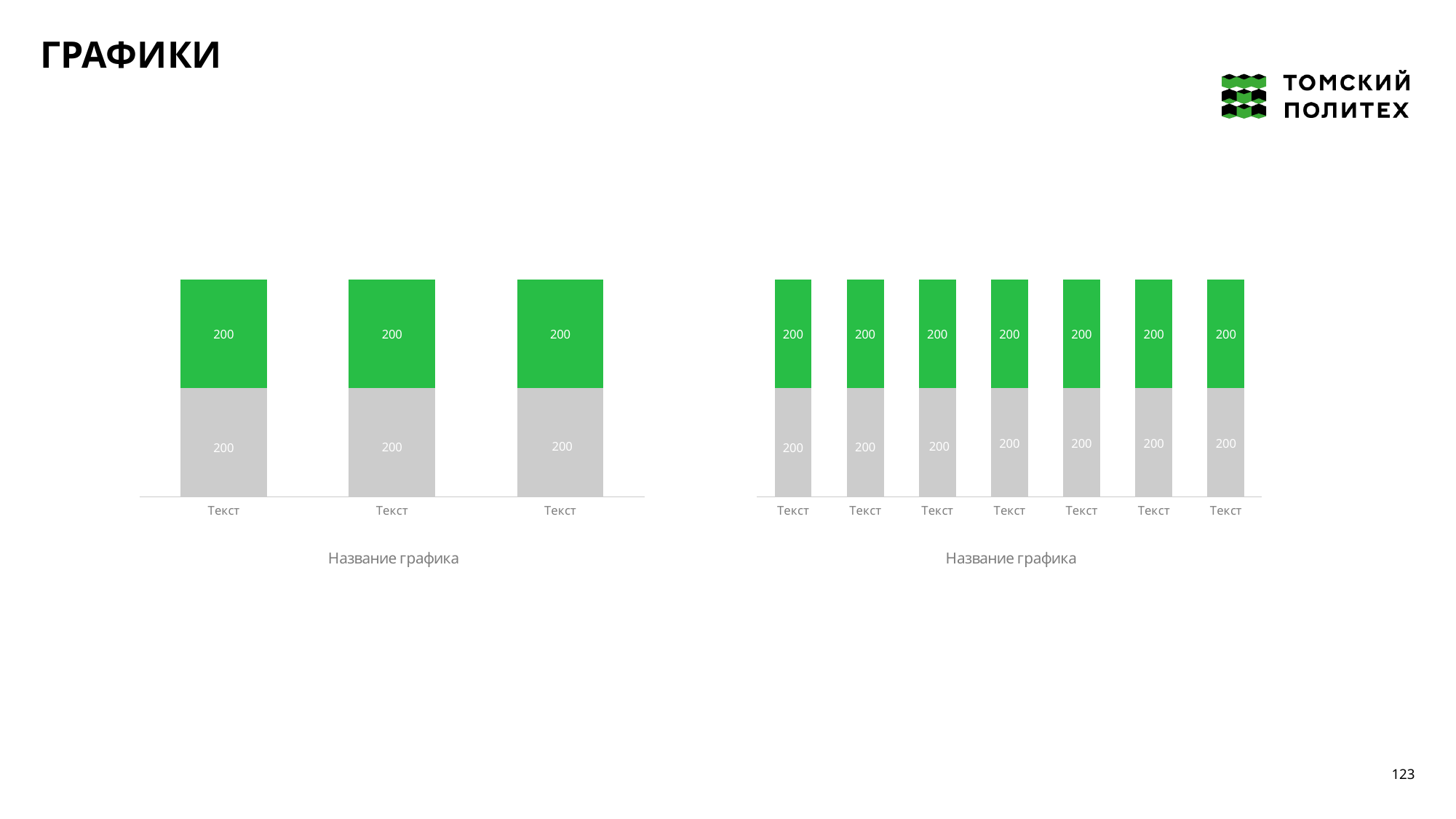
In the right chart, what is the value of the green segment of the last bar? 200 In the right chart, what is the value of the grey segment of the fourth bar? 200 What kind of chart is the left chart on the slide? stacked bar chart In the left chart, what is the total of the first stacked bar? 400 What is the title shown under the right chart? Название графика How many bars does the left chart have? 3 In the left chart, what is the value of the green segment of the first bar? 200 In the left chart, what is the difference between the green and grey segments of the second bar? 0 How many bars does the right chart have? 7 In the left chart, what is the value of the grey segment of the third bar? 200 In the right chart, what is the total of the seventh stacked bar? 400 What kind of chart is the right chart on the slide? stacked bar chart